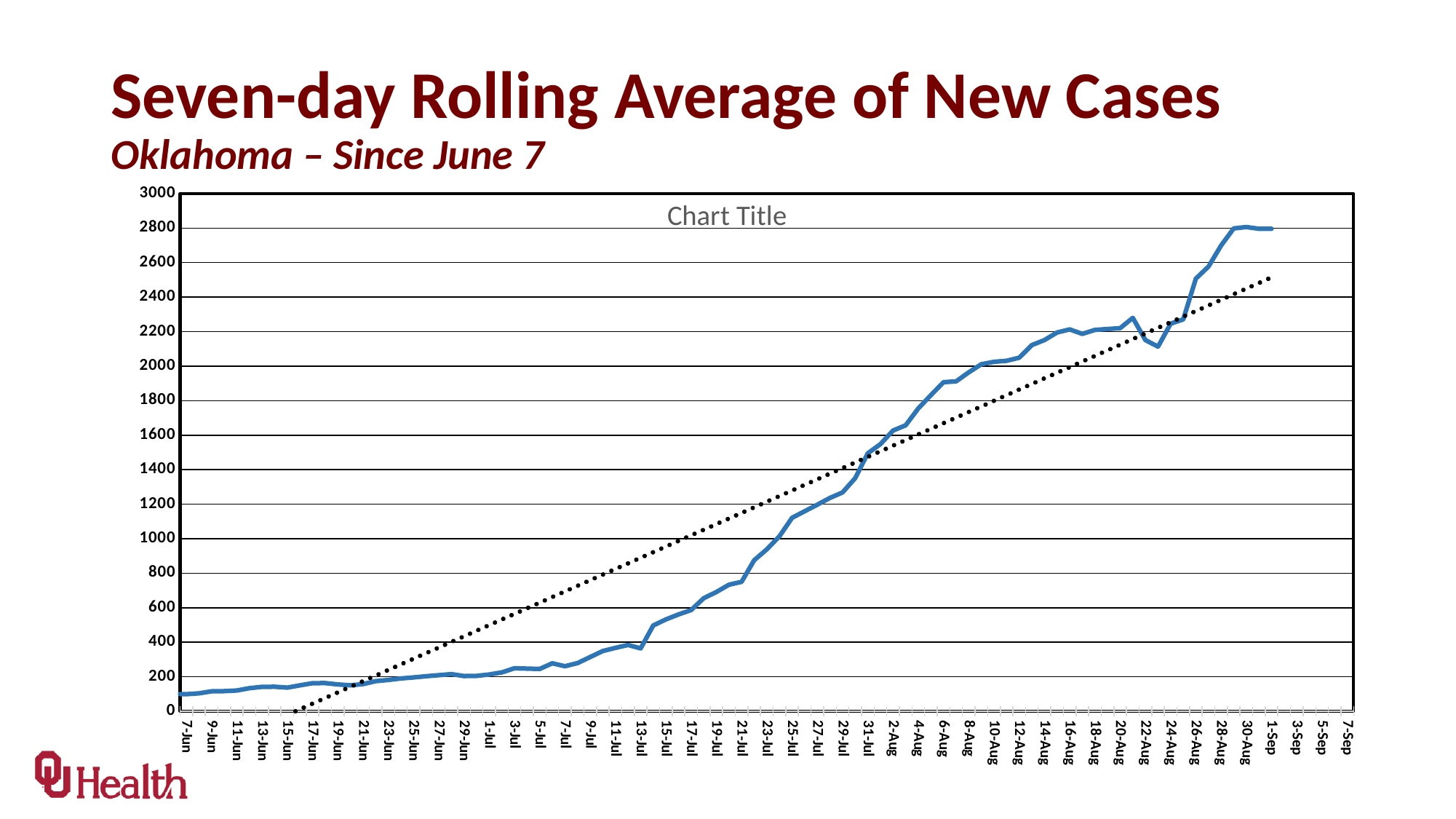
Is the value of the blue line on 7-Jun greater or less than 200? less Is the value of the blue line on 15-Jul greater or less than 600? less Is the value of the blue line on 25-Jul greater or less than 1000? greater Which date has the larger value on the blue line, 17-Jul or 17-Aug? 17-Aug On which date does the blue line have its lowest value? 7-Jun What kind of chart is shown on the slide? line chart Do the values of the solid blue line generally rise or fall from 7-Jun to 1-Sep? rise What placeholder title text appears inside the chart area? Chart Title What is the highest value shown on the vertical axis? 3000